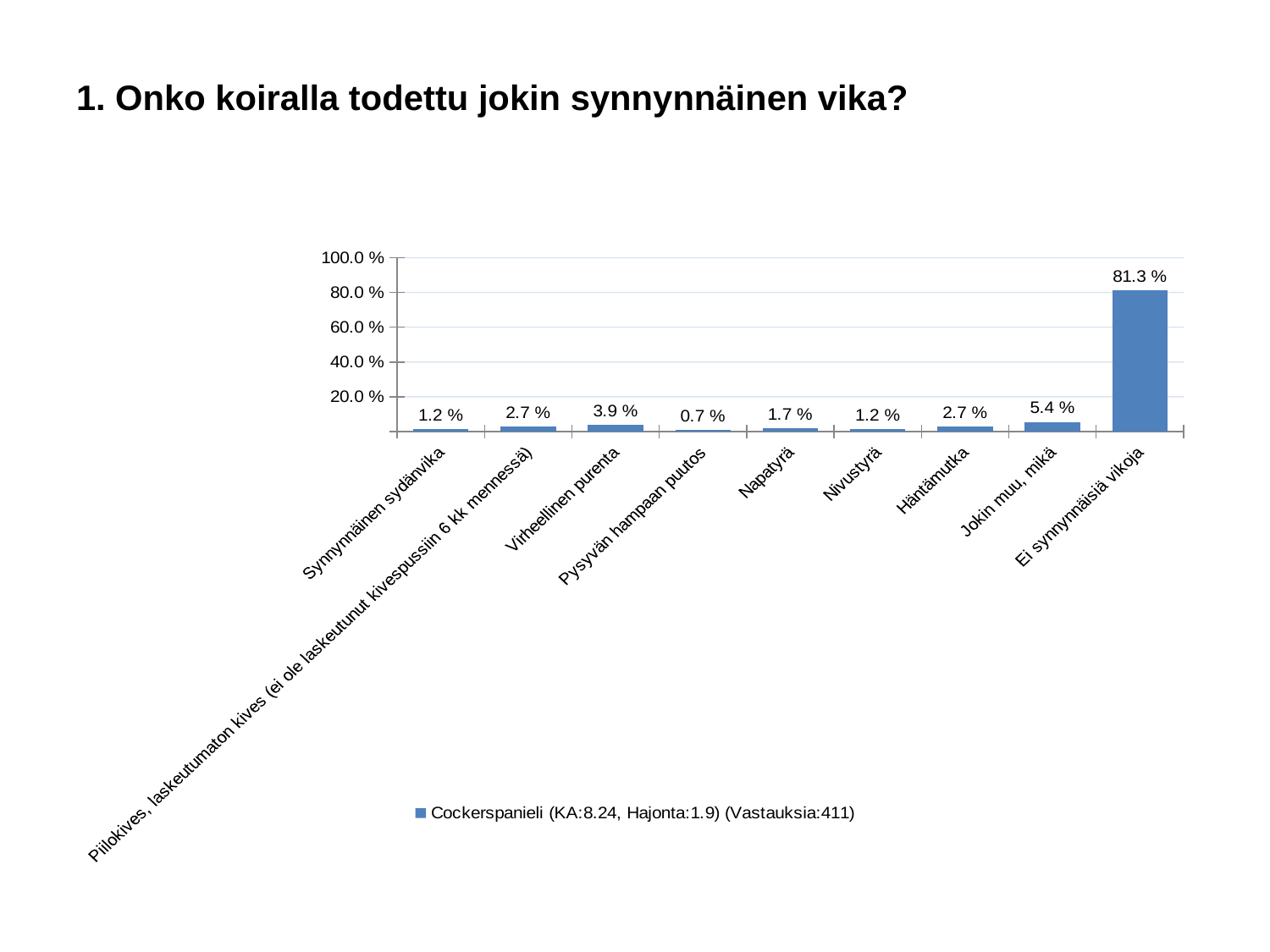
Is the value for "Ei synnynnäisiä vikoja" greater or less than 80.0 %? greater What is the legend entry for the series? Cockerspanieli (KA:8.24, Hajonta:1.9) (Vastauksia:411) What is the value for "Virheellinen purenta"? 3.9 % What is the value for "Ei synnynnäisiä vikoja"? 81.3 % What is the difference between the values for "Jokin muu, mikä" and "Virheellinen purenta"? 1.5 % How many categories are shown on the x axis? 9 What is the value for "Jokin muu, mikä"? 5.4 % Which category has the highest value? Ei synnynnäisiä vikoja What is the value for "Napatyrä"? 1.7 % Which is larger, the value for "Häntämutka" or the value for "Nivustyrä"? Häntämutka What kind of chart is shown on the slide? bar chart Which category has the lowest value? Pysyvän hampaan puutos